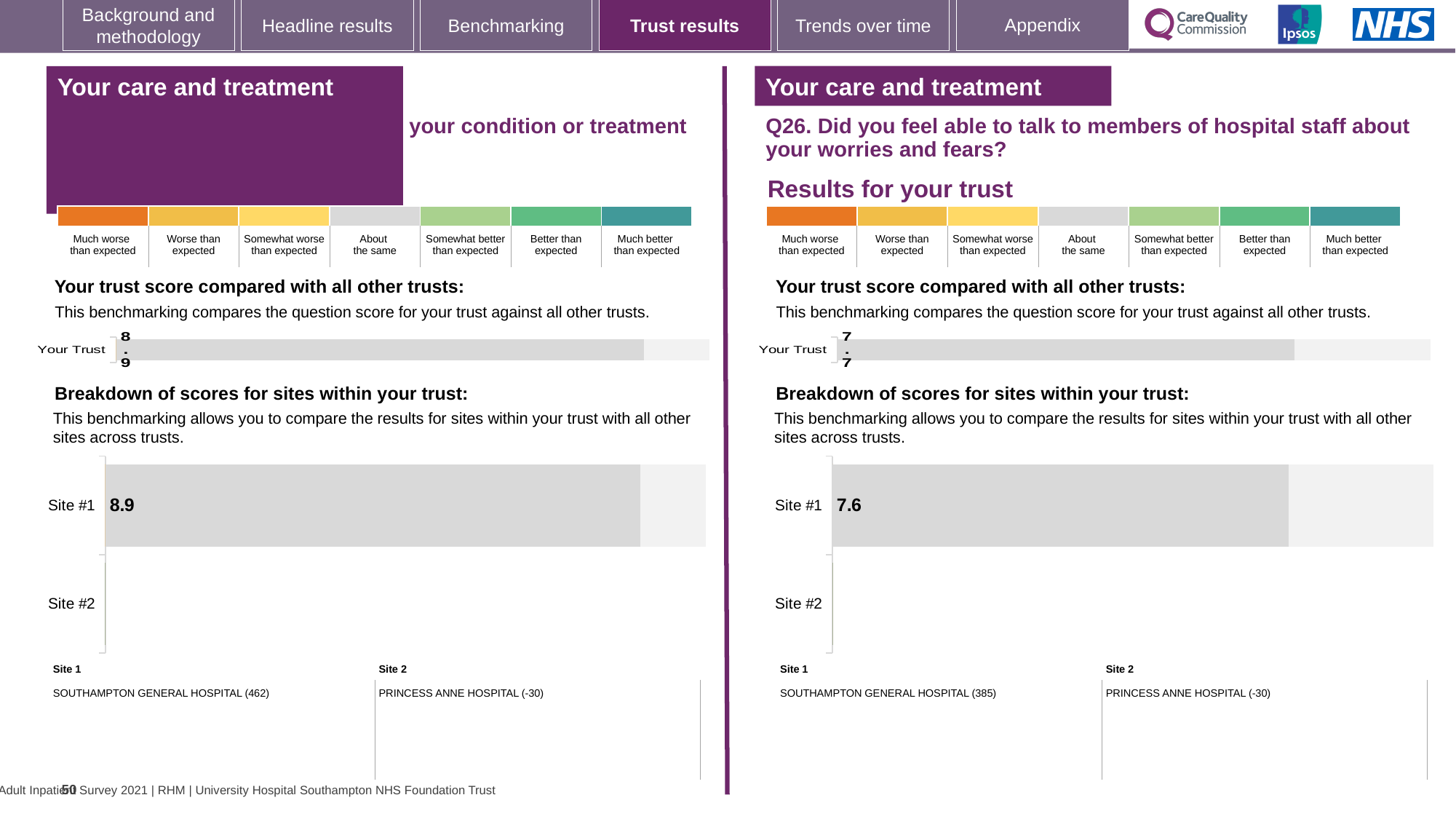
What type of chart is used to show the Site #1 and Site #2 scores on the right half of the slide? Bar chart In the right 'Breakdown of scores for sites within your trust' chart (Q26), what is the score for Site #1? 7.6 On the right half of the slide, which hospital is listed as Site 1? SOUTHAMPTON GENERAL HOSPITAL (385) What is the difference between the Site #1 score in the left breakdown chart and the Site #1 score in the right breakdown chart? 1.3 In the right breakdown chart (Q26), which site has a bar plotted? Site #1 In the left 'Breakdown of scores for sites within your trust' chart, what is the score for Site #1? 8.9 Which is larger: the Site #1 score in the left breakdown chart or the Site #1 score in the right breakdown chart? Left (8.9) On the right half of the slide (Q26), what is the score shown for Your Trust in the 'Your trust score compared with all other trusts' chart? 7.7 What is the difference between the Your Trust score on the left half and the Your Trust score on the right half of the slide? 1.2 On the left half of the slide, what is the score shown for Your Trust in the 'Your trust score compared with all other trusts' chart? 8.9 Is the Your Trust score on the right half of the slide (Q26) greater or less than the Site #1 score in the right breakdown chart? greater How many sites are listed on the axis of the left 'Breakdown of scores for sites within your trust' chart? 2